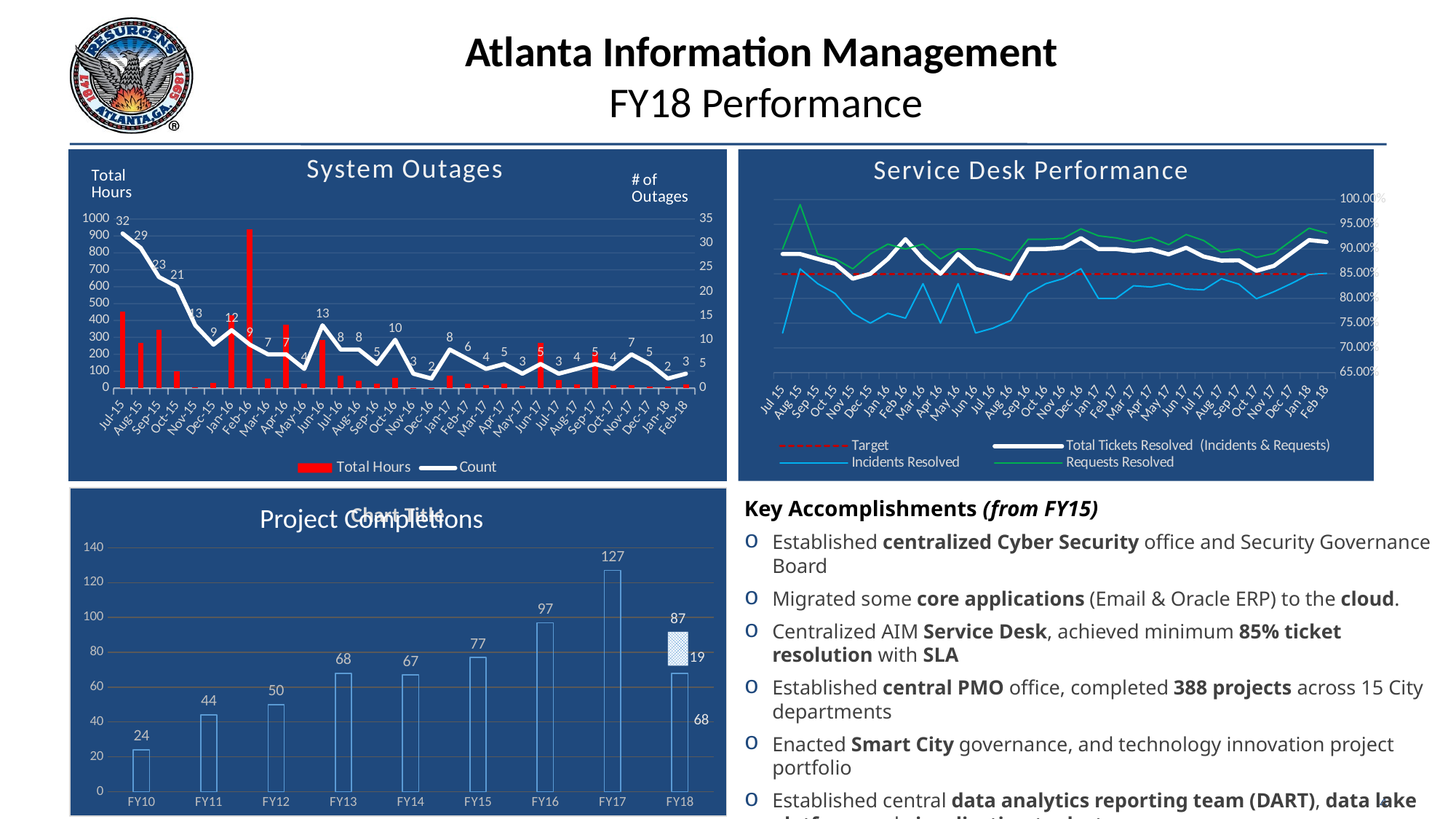
How many series does the legend of the Service Desk Performance chart list? 4 In the Project Completions chart, what is the difference between the FY16 and FY15 values? 20 In the Service Desk Performance chart, is the Incidents Resolved value for Aug 15 greater or less than 80.00%? greater What kind of chart is the Project Completions chart? bar chart In the Project Completions chart, which fiscal year has the lowest number of project completions? FY10 In the Project Completions chart, which fiscal year has the highest number of project completions? FY17 In the System Outages chart, what is the Count value for Jul-15? 32 In the System Outages chart, which month has the tallest Total Hours bar? Feb-16 In the Project Completions chart, what is the total of the stacked FY18 bar? 87 In the Project Completions chart, how many projects were completed in FY17? 127 How many fiscal years are shown in the Project Completions chart? 9 In the System Outages chart, does the Count line generally rise or fall from Jul-15 to Feb-18? fall